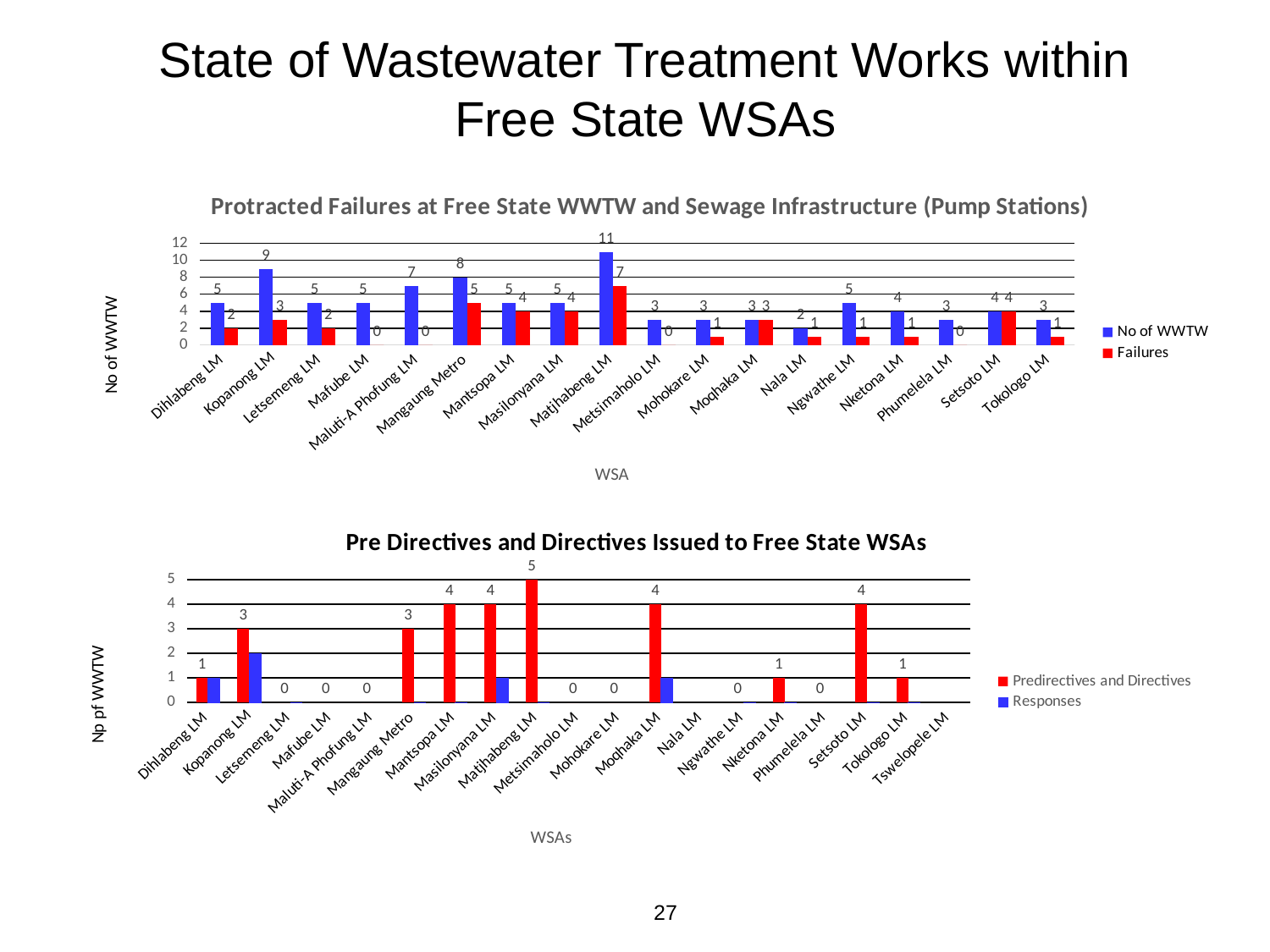
In the bottom chart, Pre Directives and Directives Issued to Free State WSAs, what is the Predirectives and Directives value for Kopanong LM? 3 In the top chart, Protracted Failures at Free State WWTW, what is the difference between the No of WWTW and Failures for Kopanong LM? 6 What type of chart is the bottom chart, Pre Directives and Directives Issued to Free State WSAs? Bar chart In the top chart, Protracted Failures at Free State WWTW, what is the No of WWTW value for Matjhabeng LM? 11 In the top chart, Protracted Failures at Free State WWTW, what is the Failures value for Mangaung Metro? 5 In the bottom chart, Pre Directives and Directives Issued to Free State WSAs, how many WSAs are shown on the x axis? 19 In the bottom chart, Pre Directives and Directives Issued to Free State WSAs, which WSA has the highest Predirectives and Directives value? Matjhabeng LM In the top chart, Protracted Failures at Free State WWTW, which WSA has the lowest No of WWTW? Nala LM In the top chart, Protracted Failures at Free State WWTW, which is larger: the Failures value for Matjhabeng LM or for Mangaung Metro? Matjhabeng LM In the bottom chart, Pre Directives and Directives Issued to Free State WSAs, what is the Predirectives and Directives value for Matjhabeng LM? 5 In the top chart, Protracted Failures at Free State WWTW, how many series does the legend list? 2 In the top chart, Protracted Failures at Free State WWTW, which WSA has the highest No of WWTW? Matjhabeng LM